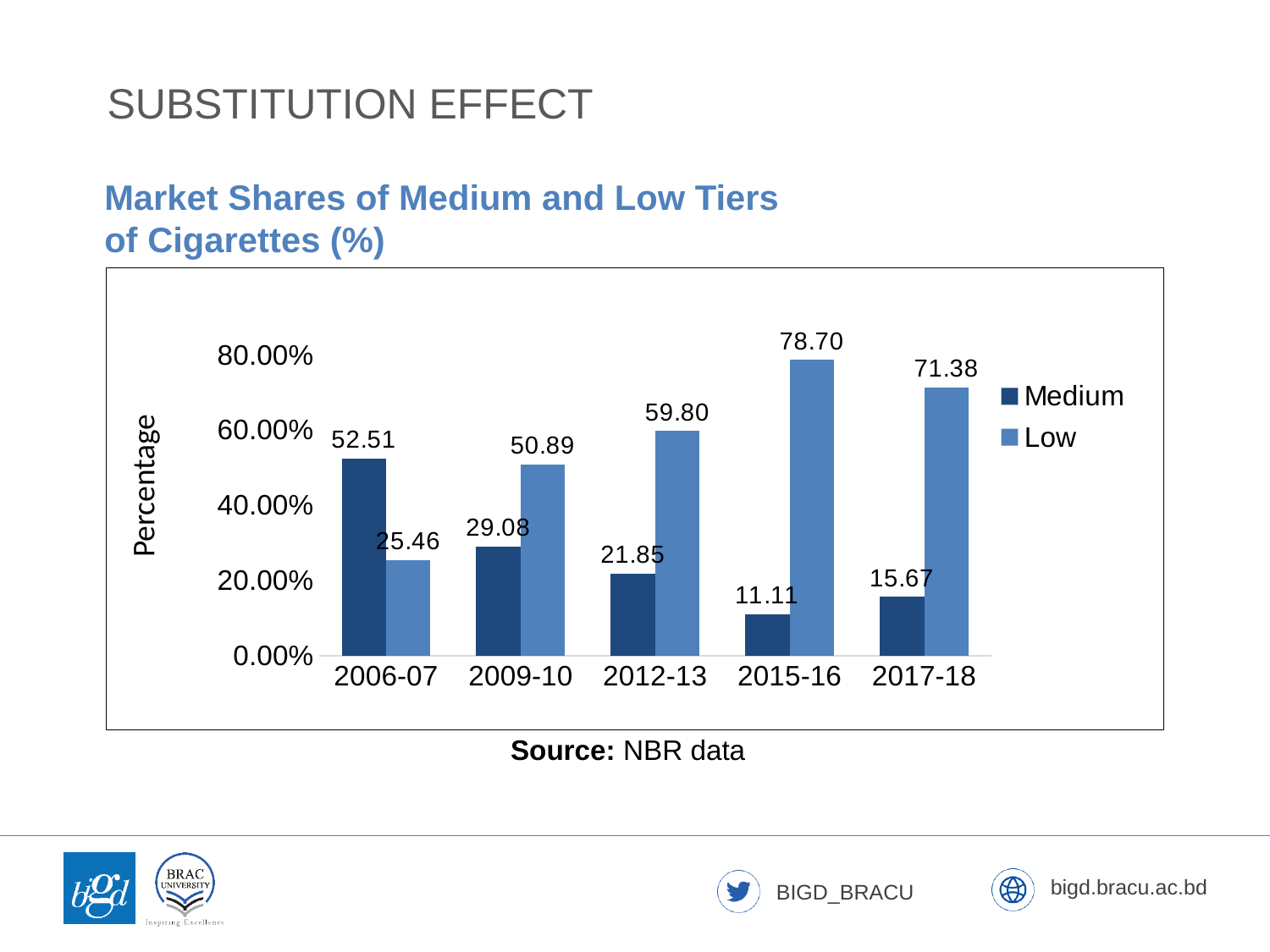
Which is larger in 2006-07, the Medium tier share or the Low tier share? Medium What is the market share of the Medium tier in 2017-18? 15.67 What is the difference between the Low and Medium tier market shares in 2012-13? 37.95 What is the market share of the Medium tier in 2006-07? 52.51 Is the Low tier market share in 2017-18 greater or less than 60.00%? greater What is the market share of the Low tier in 2015-16? 78.70 In which year is the Low tier market share highest? 2015-16 What kind of chart is shown on the slide? Bar chart In which year is the Medium tier market share lowest? 2015-16 How many years are shown on the x axis of the chart? 5 Does the Medium tier market share generally rise or fall from 2006-07 to 2015-16? Fall How many series does the legend list? 2